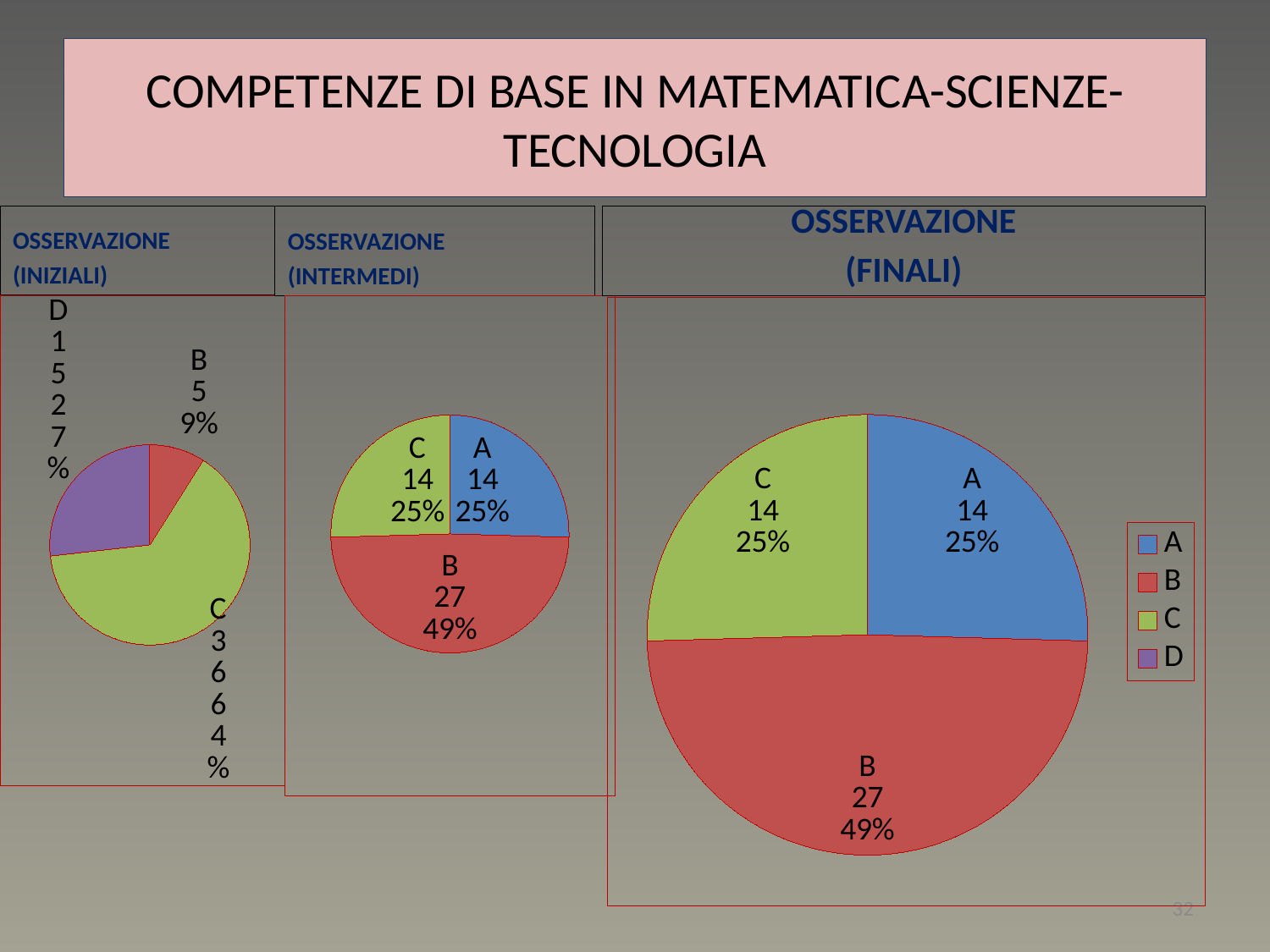
What kind of chart is the OSSERVAZIONE (INTERMEDI) chart? Pie chart In the OSSERVAZIONE (FINALI) chart, what percentage is shown for category A? 25% In the OSSERVAZIONE (INIZIALI) chart, what percentage is shown for category B? 9% In the OSSERVAZIONE (FINALI) chart, which category has the largest slice? B In the OSSERVAZIONE (INIZIALI) chart, which is larger, the value for D or the value for B? D In the OSSERVAZIONE (INTERMEDI) chart, what is the difference between the values for B and A? 13 In the OSSERVAZIONE (INTERMEDI) chart, what value is shown for category C? 14 In the OSSERVAZIONE (FINALI) chart, what value is shown for category B? 27 In the OSSERVAZIONE (INIZIALI) chart, which category has the largest slice? C In the OSSERVAZIONE (INIZIALI) chart, what value is shown for category C? 36 In the OSSERVAZIONE (INIZIALI) chart, which category has the smallest slice? B How many entries does the legend of the OSSERVAZIONE (FINALI) chart list? 4